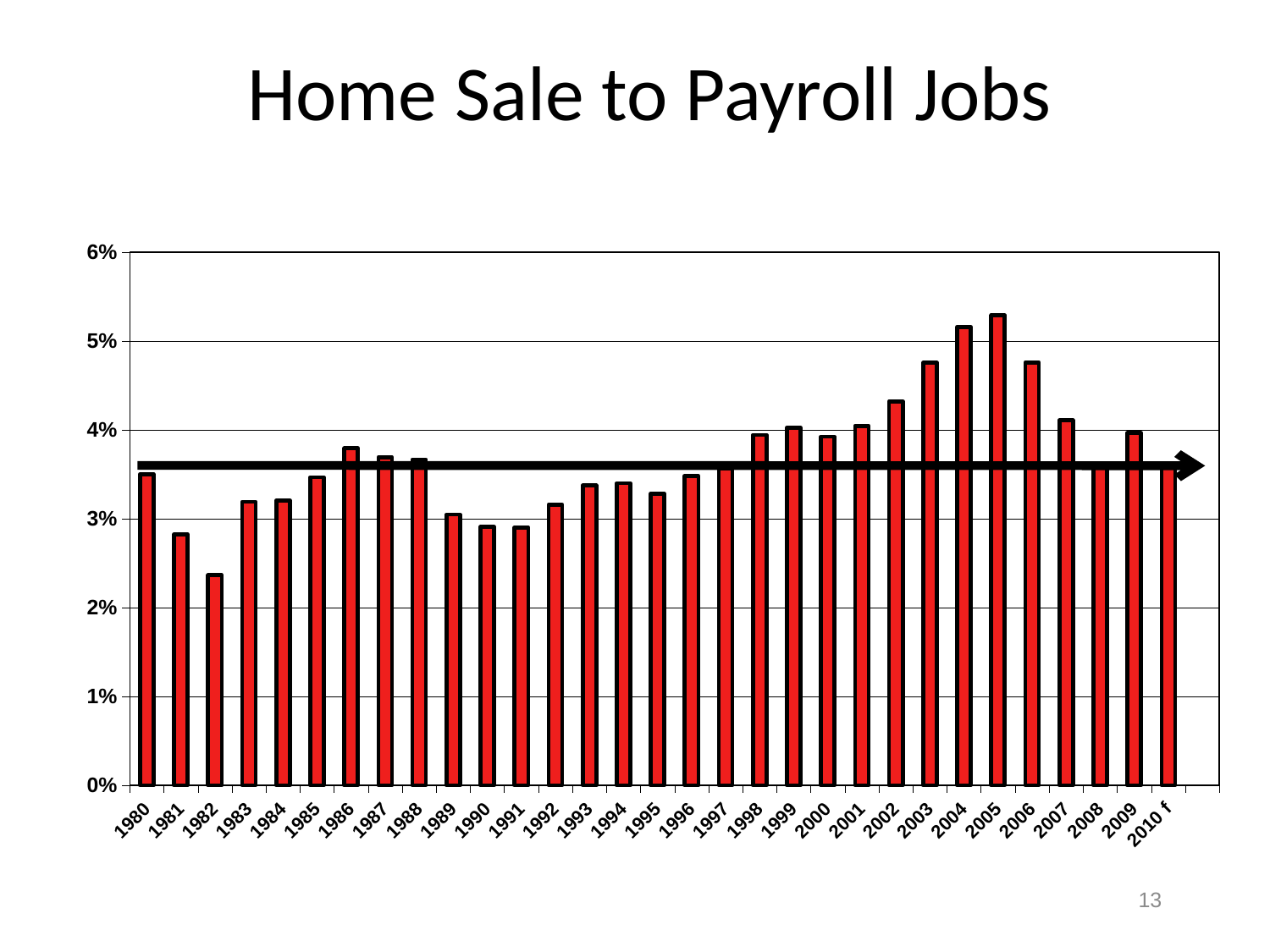
Is the value for 1982 greater or less than 3%? less Which year has the lowest value on the chart? 1982 Is the value for 1990 greater or less than 3%? less Is the value for 2004 greater or less than 5%? greater Which year has the highest value on the chart? 2005 Which is larger, the value for 2006 or the value for 2007? 2006 What is the title of the chart on the slide? Home Sale to Payroll Jobs Do the values generally rise or fall from 2005 to 2008? fall Which is larger, the value for 1981 or the value for 1985? 1985 What kind of chart is shown on the slide? bar chart How many years (bars) are plotted on the chart? 31